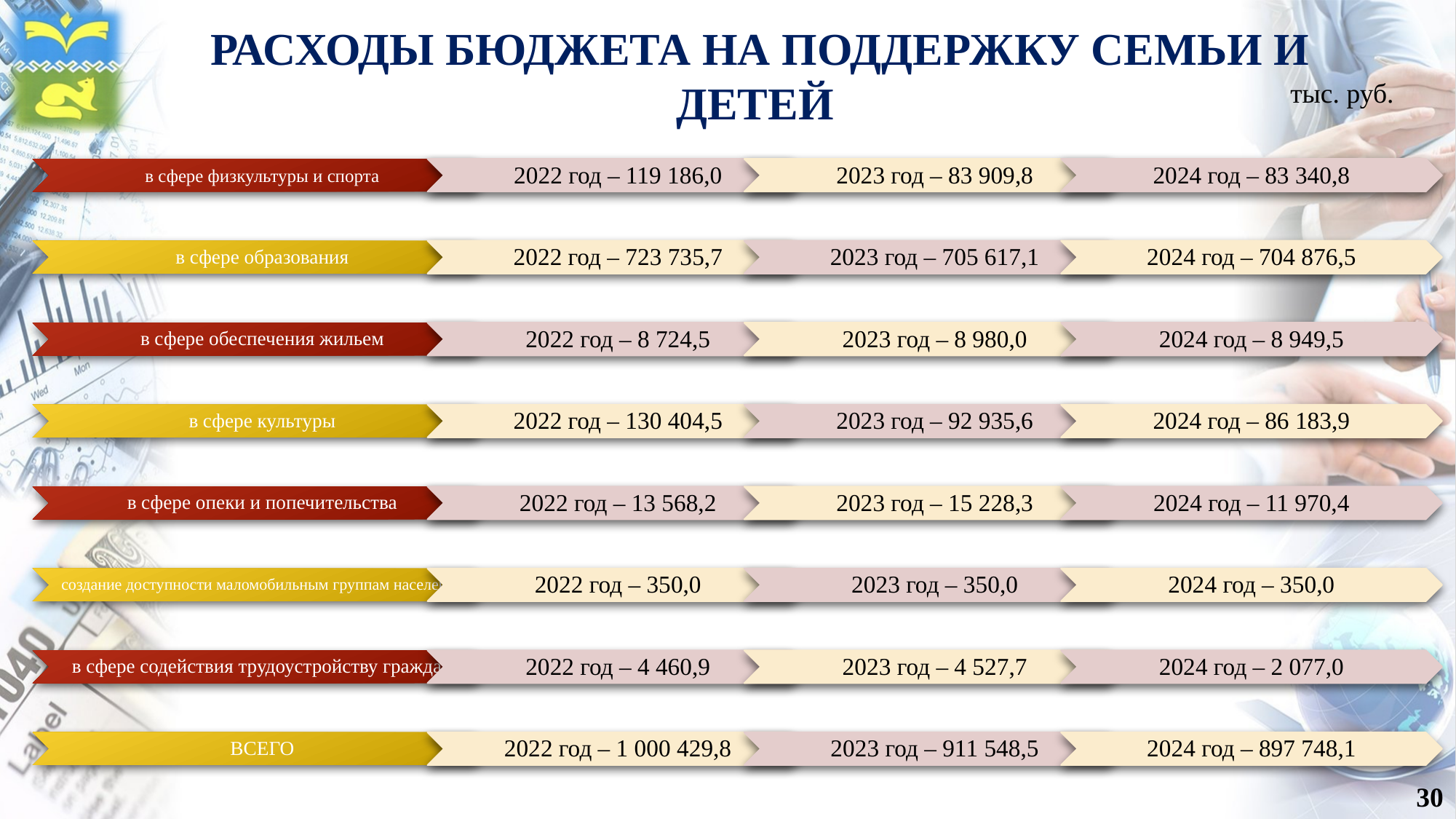
Which sphere (excluding ВСЕГО) has the highest expenditure in 2022? в сфере образования How many years are shown for each sphere? 3 What is the difference between the ВСЕГО values for 2022 and 2024? 102 681,7 What is the budget expenditure in the sphere of education (в сфере образования) for 2022? 723 735,7 What is the value for в сфере опеки и попечительства in 2023? 15 228,3 In what units are the values on the slide given? тыс. руб. What is the value for в сфере культуры in 2024? 86 183,9 What is the total (ВСЕГО) expenditure for 2023? 911 548,5 What is the difference between the 2022 and 2023 values for в сфере образования? 18 118,6 Which is larger: the 2023 value for в сфере физкультуры и спорта or the 2023 value for в сфере культуры? в сфере культуры Which sphere (excluding ВСЕГО) has the lowest expenditure in 2024? создание доступности маломобильным группам населения How do the ВСЕГО values change from 2022 to 2024? They fall